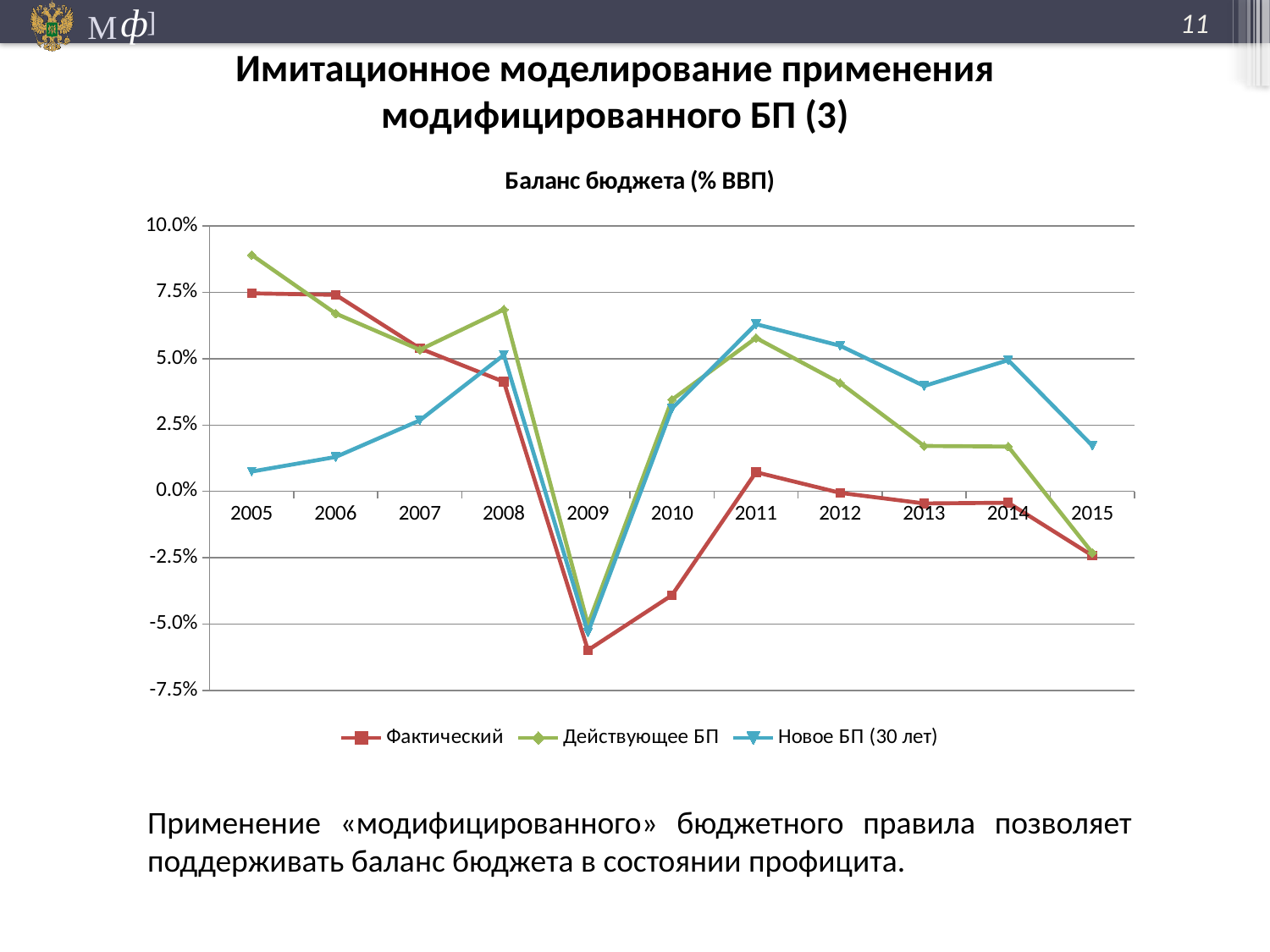
In 2015, which series has the higher value: Новое БП (30 лет) or Фактический? Новое БП (30 лет) In which year does the Действующее БП series reach its highest value? 2005 Does the Новое БП (30 лет) series rise or fall from 2005 to 2008? rise How many years are plotted along the x axis? 11 In which year does the Фактический series reach its lowest value? 2009 What is the title of the chart? Баланс бюджета (% ВВП) Is the value for Фактический in 2009 greater or less than -5.0%? less How many series does the legend list? 3 Which series is drawn in red? Фактический Is the value for Действующее БП in 2005 greater or less than 7.5%? greater In which year does the Новое БП (30 лет) series reach its highest value? 2011 What kind of chart is shown on the slide? line chart